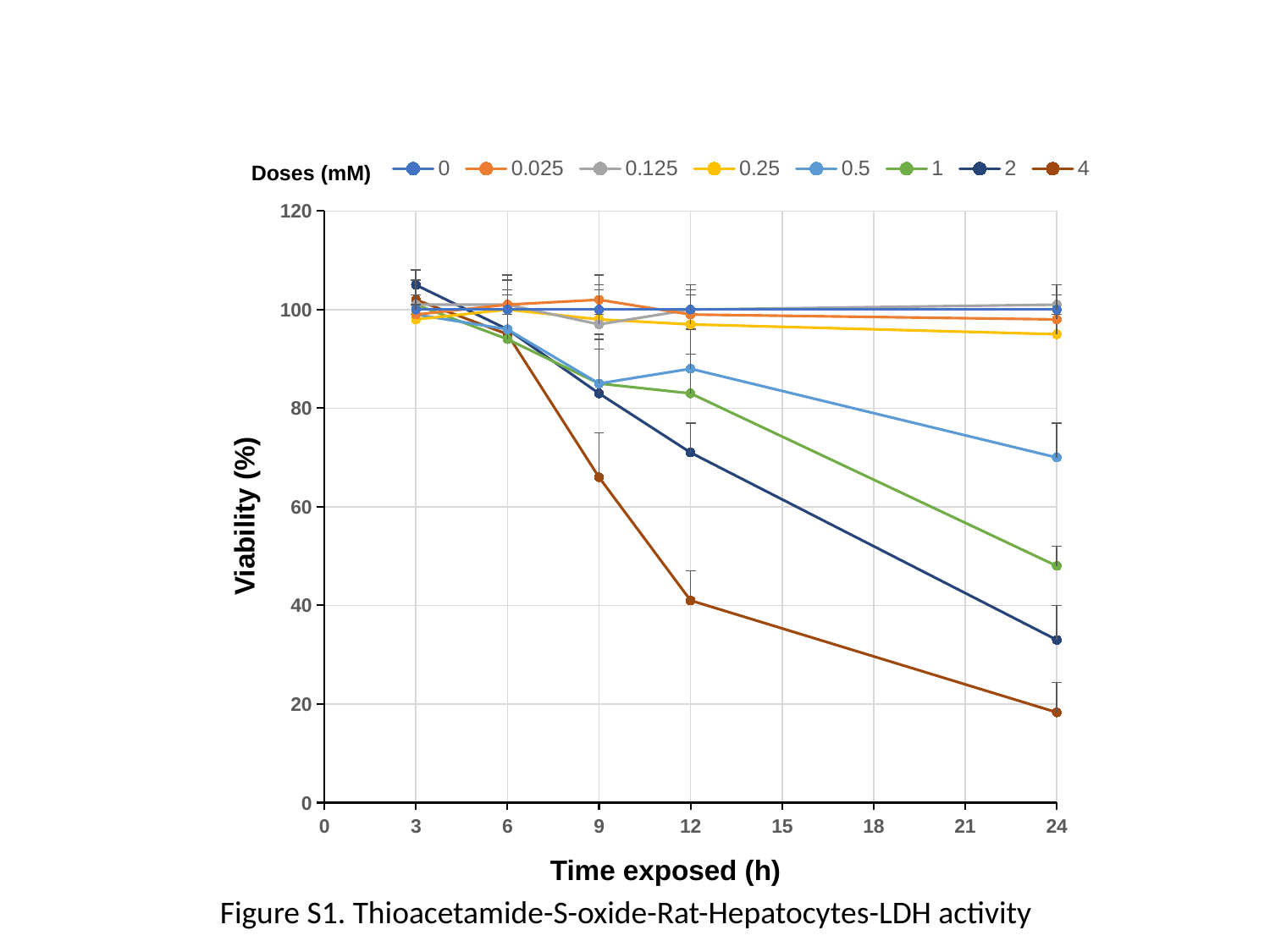
What kind of chart is shown on the slide? line chart How many dose series does the legend list? 8 How many time points are plotted for each dose series? 5 Is the viability for the 0.5 mM dose at 24 h greater or less than 60? greater At 24 h, which has the higher viability: the 1 mM dose or the 2 mM dose? 1 mM Is the viability for the 2 mM dose at 24 h greater or less than 40? less Is the viability for the 1 mM dose at 24 h greater or less than 60? less Does the viability for the 4 mM dose rise or fall as time exposed increases? fall What is the label of the y axis? Viability (%) Which dose series has the lowest viability at 24 h? 4